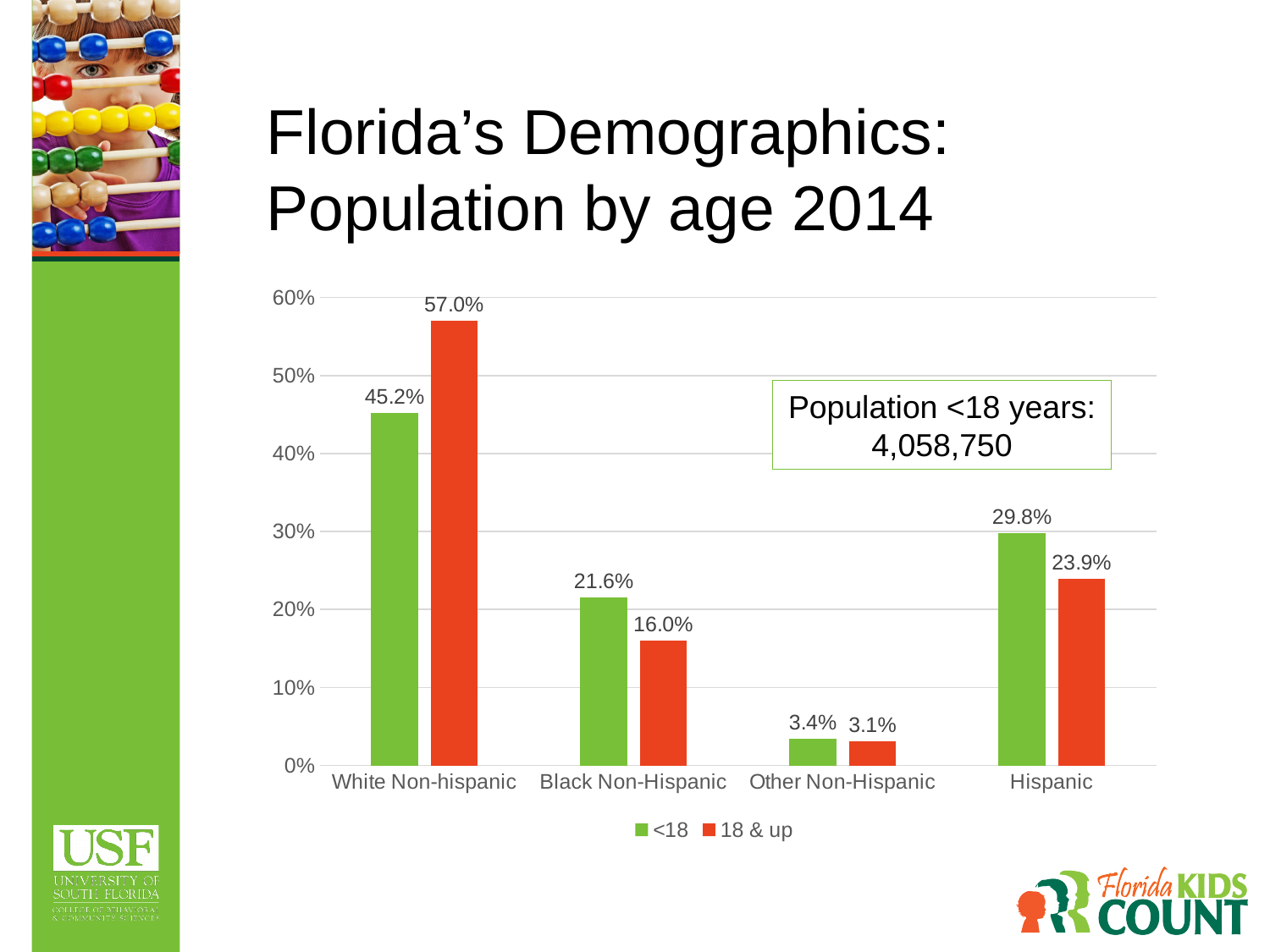
Which category has the lowest value in the <18 series? Other Non-Hispanic What is the value for Hispanic in the 18 & up series? 23.9% What kind of chart is shown on the slide? Bar chart What is the value for White Non-hispanic in the <18 series? 45.2% Which is larger for Black Non-Hispanic, the <18 value or the 18 & up value? <18 What is the value for Black Non-Hispanic in the 18 & up series? 16.0% How many categories are shown on the x axis? 4 What is the difference between the 18 & up and <18 values for White Non-hispanic? 11.8% Which category has the highest value in the 18 & up series? White Non-hispanic What population figure is given in the text box for Population <18 years? 4,058,750 How many series does the legend list? 2 What is the difference between the <18 and 18 & up values for Hispanic? 5.9%